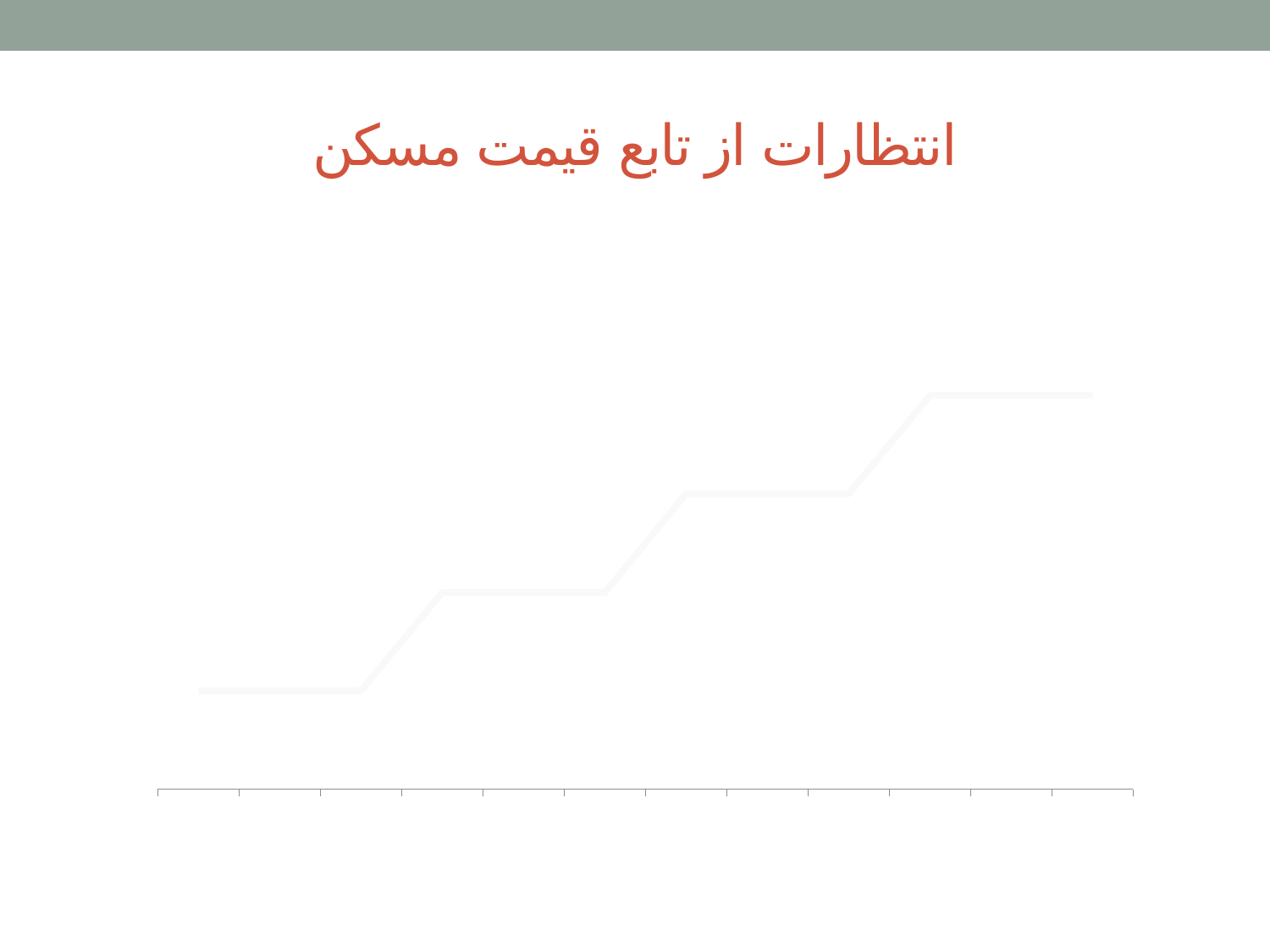
Does the chart display a legend? No What kind of chart is shown on the slide? line chart Do the values of the line rise or fall from left to right along the x axis? rise What is the title shown above the chart on the slide? انتظارات از تابع قیمت مسکن